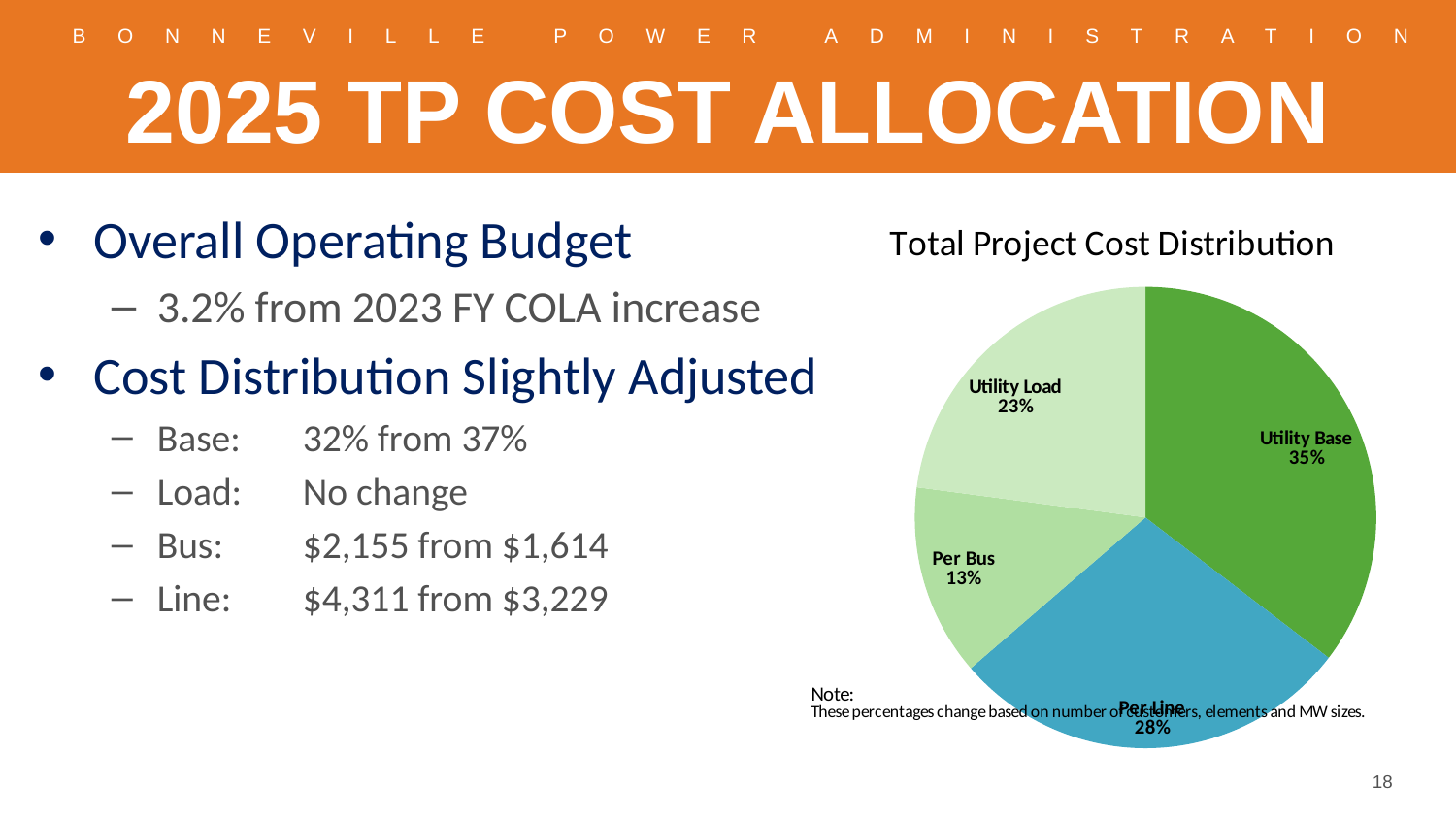
What share of the pie does Utility Base represent? 35% What is the title of the chart? Total Project Cost Distribution How many slices does the pie chart have? 4 Which slice of the pie is the smallest? Per Bus What kind of chart is shown on the slide? pie chart What share of the pie does Utility Load represent? 23% What is the difference in percentage points between Utility Base and Per Bus? 22 What share of the pie does Per Bus represent? 13% What is the combined share of Utility Base and Utility Load? 58% Which is larger, Per Line or Utility Load? Per Line Which slice of the pie is the largest? Utility Base